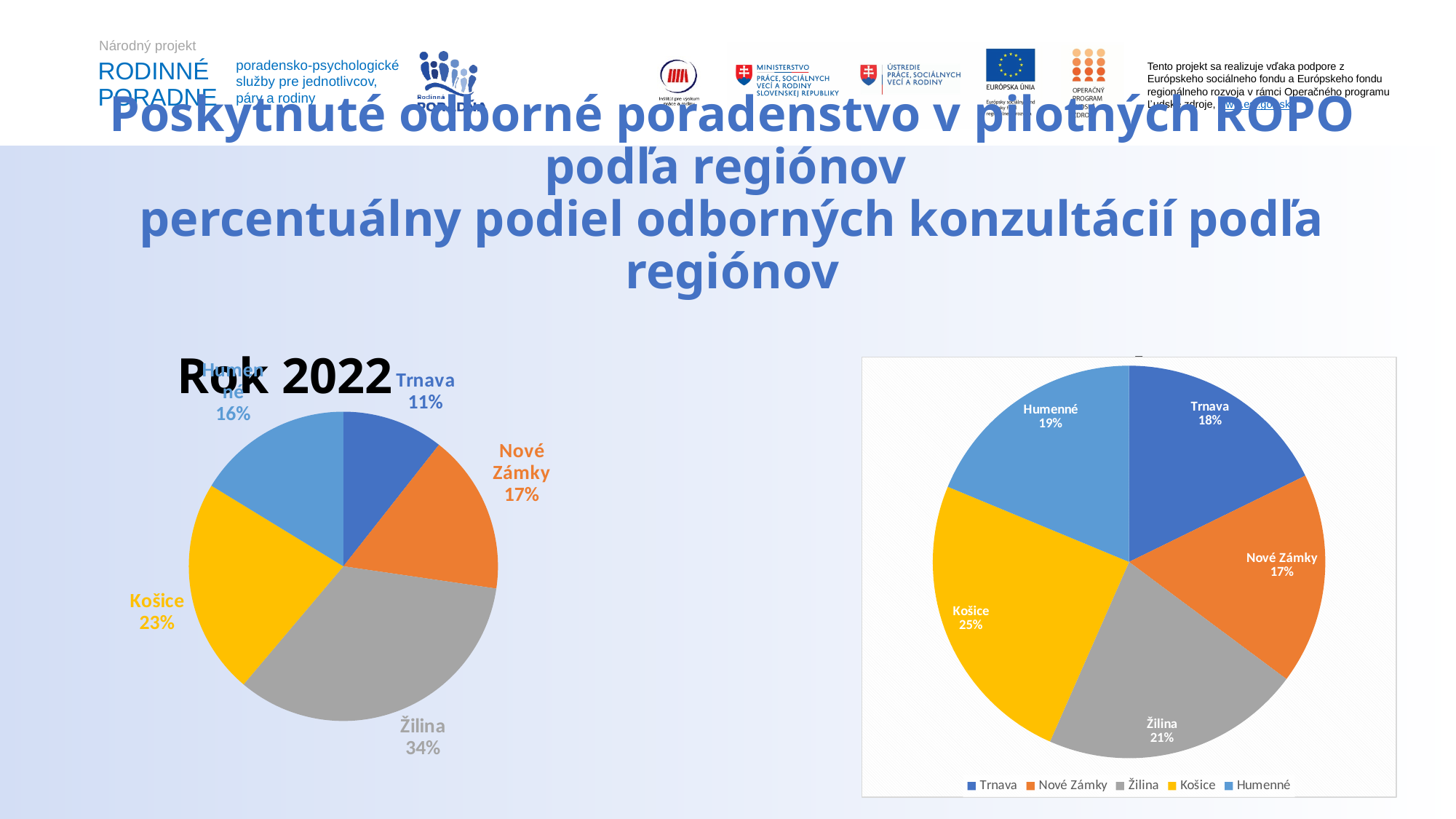
In the 'Rok 2022' pie chart, which region has the largest share? Žilina How many regions does the legend of the pie chart on the right list? 5 In the 'Rok 2022' pie chart, which has the larger share, Nové Zámky or Humenné? Nové Zámky In the 'Rok 2022' pie chart, which region has the smallest share? Trnava In the pie chart on the right, which region has the largest share? Košice In the 'Rok 2022' pie chart, what share does Košice have? 23% What type of chart is the 'Rok 2022' chart? Pie chart In the pie chart on the right, what share does Košice have? 25% In the 'Rok 2022' pie chart, what is the difference between the shares of Žilina and Trnava? 23% In the 'Rok 2022' pie chart, what share does Žilina have? 34% In the pie chart on the right, what share does Humenné have? 19% In the pie chart on the right, which region has the smallest share? Nové Zámky